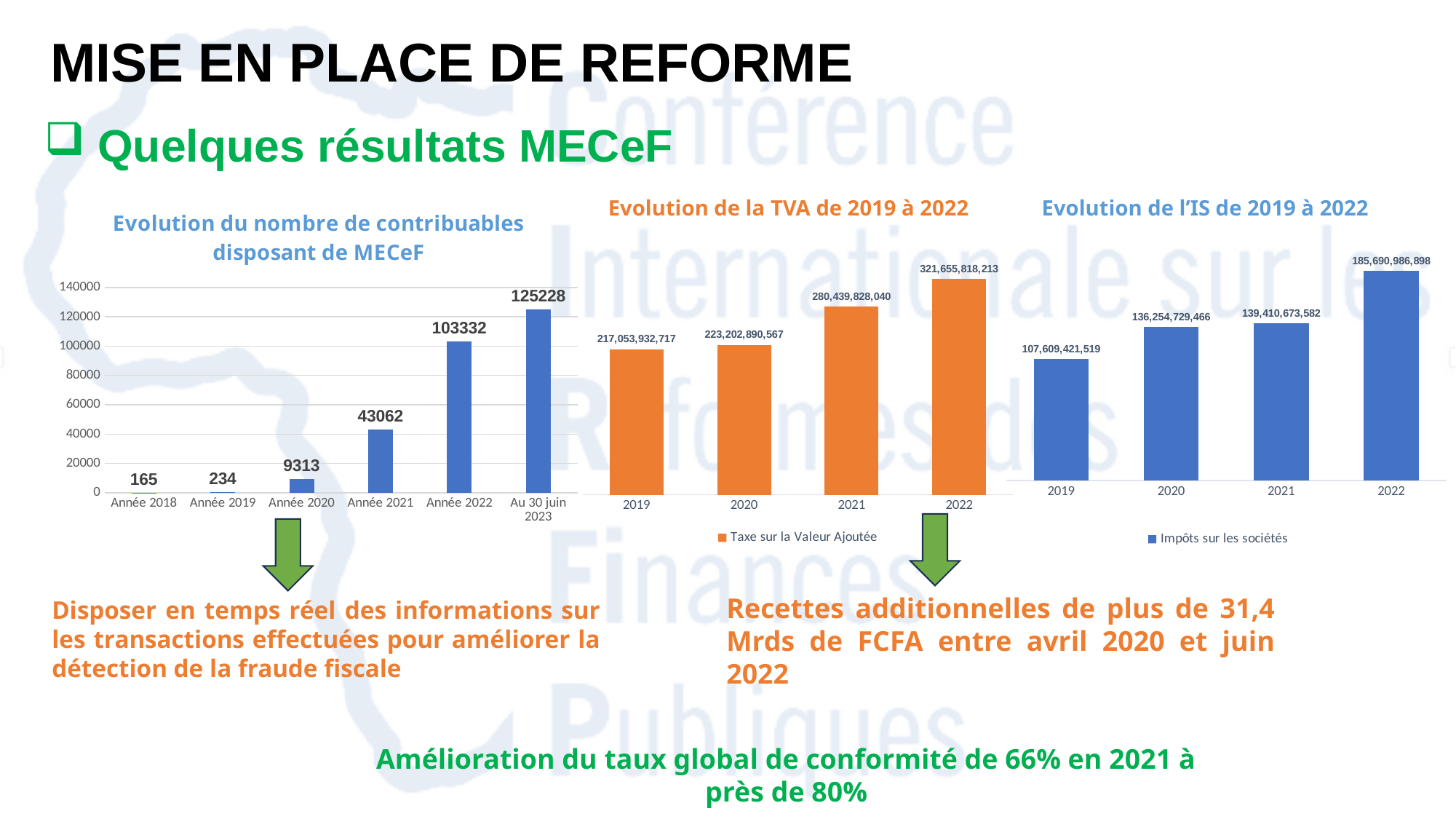
In the chart 'Evolution de la TVA de 2019 à 2022', what is the value for 2021? 280,439,828,040 In the chart 'Evolution de l'IS de 2019 à 2022', what is the difference between the values for 2022 and 2021? 46,280,313,316 In the chart 'Evolution de la TVA de 2019 à 2022', what is the difference between the values for 2022 and 2021? 41,215,990,173 In the chart 'Evolution du nombre de contribuables disposant de MECeF', which category has the lowest value? Année 2018 In the chart 'Evolution de la TVA de 2019 à 2022', what series name does the legend show? Taxe sur la Valeur Ajoutée In the chart 'Evolution du nombre de contribuables disposant de MECeF', what is the difference between the values for Au 30 juin 2023 and Année 2022? 21896 In the chart 'Evolution du nombre de contribuables disposant de MECeF', do the values rise or fall from Année 2018 to Au 30 juin 2023? rise In the chart 'Evolution du nombre de contribuables disposant de MECeF', how many categories are shown on the x axis? 6 In the chart 'Evolution de l'IS de 2019 à 2022', what is the value for 2019? 107,609,421,519 In the chart 'Evolution du nombre de contribuables disposant de MECeF', what is the value for Au 30 juin 2023? 125228 In the chart 'Evolution du nombre de contribuables disposant de MECeF', what is the value for Année 2021? 43062 In the chart 'Evolution de la TVA de 2019 à 2022', which year has the highest value? 2022